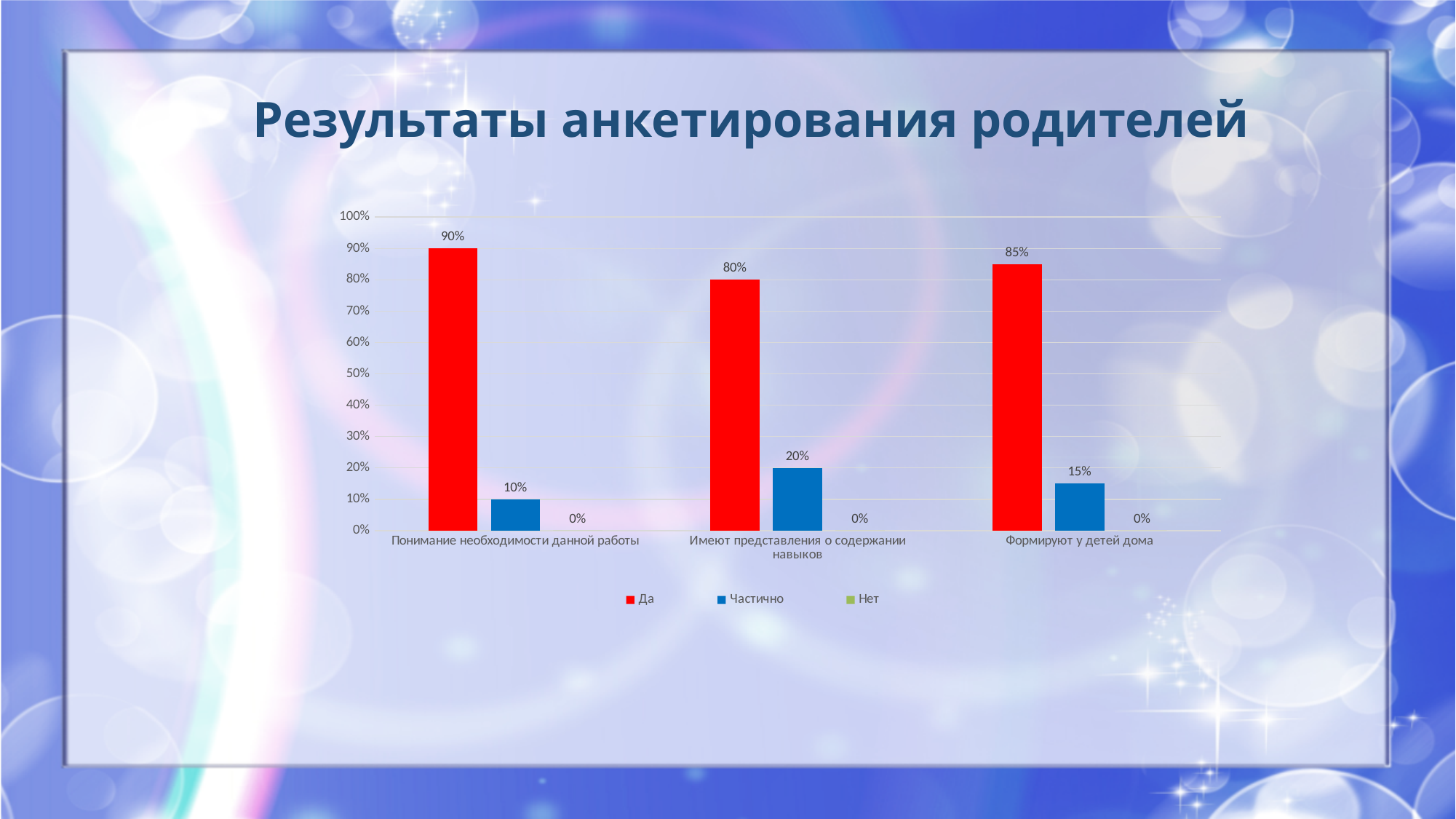
What is the title of the slide? Результаты анкетирования родителей What is the value of "Да" for "Формируют у детей дома"? 85% How many categories are shown on the x axis? 3 What is the difference between the "Да" values for "Понимание необходимости данной работы" and "Имеют представления о содержании навыков"? 10% What kind of chart is shown on the slide? Bar chart Which category has the lowest value for the "Частично" series? Понимание необходимости данной работы How many series does the legend list? 3 Which category has the highest value for the "Да" series? Понимание необходимости данной работы What is the value of "Нет" for "Формируют у детей дома"? 0% What is the value of "Да" for "Понимание необходимости данной работы"? 90% Which is larger: the "Частично" value for "Имеют представления о содержании навыков" or for "Формируют у детей дома"? Имеют представления о содержании навыков What is the value of "Частично" for "Имеют представления о содержании навыков"? 20%